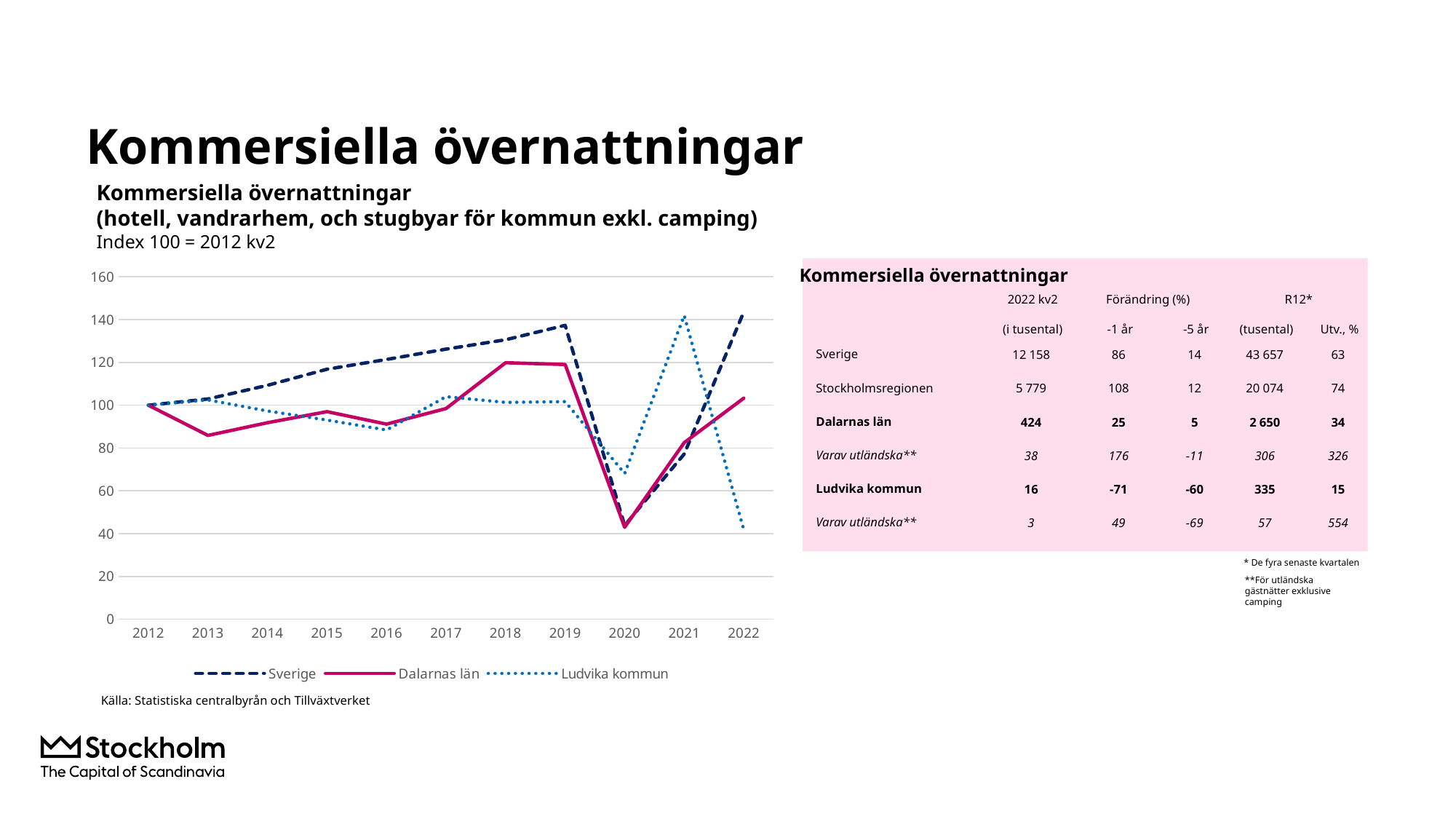
How many years are shown along the x axis of the chart? 11 What kind of chart is shown on the slide? line chart What is the index value for Sverige in 2012? 100 How many series does the chart's legend list? 3 In 2021, which series has the higher value: Ludvika kommun or Sverige? Ludvika kommun Is the value for Sverige in 2019 greater or less than 120? greater In which year does the Ludvika kommun series reach its highest value? 2021 Is the value for Ludvika kommun in 2022 greater or less than 60? less Does the Sverige series rise or fall between 2012 and 2019? rise In 2013, which series has the higher value: Sverige or Dalarnas län? Sverige In which year does the Sverige series reach its lowest value? 2020 Is the value for Ludvika kommun in 2021 greater or less than 120? greater